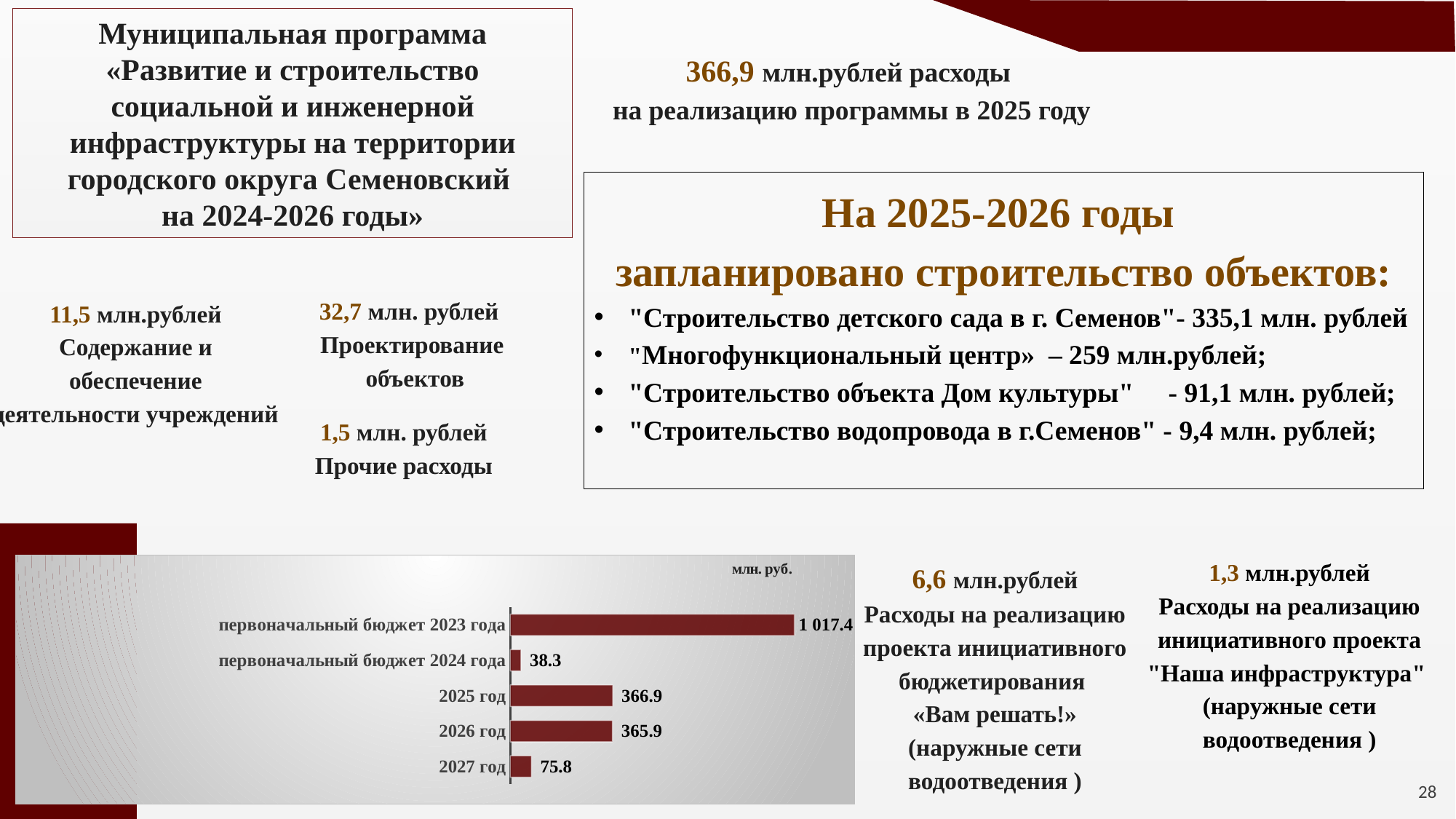
Which category has the lowest value in the chart? первоначальный бюджет 2024 года Which is larger in the chart: the value for "2027 год" or for "первоначальный бюджет 2024 года"? 2027 год What is the value for "первоначальный бюджет 2023 года" in the chart? 1 017.4 Which category has the highest value in the chart? первоначальный бюджет 2023 года What is the difference between the values for "первоначальный бюджет 2023 года" and "первоначальный бюджет 2024 года"? 979.1 What type of chart is shown at the bottom left of the slide? bar chart What is the value for "первоначальный бюджет 2024 года" in the chart? 38.3 How many categories (bars) does the chart show? 5 What is the value for "2026 год" in the chart? 365.9 What is the value for "2025 год" in the chart? 366.9 What unit label is shown in the top right corner of the chart? млн. руб. What is the value for "2027 год" in the chart? 75.8